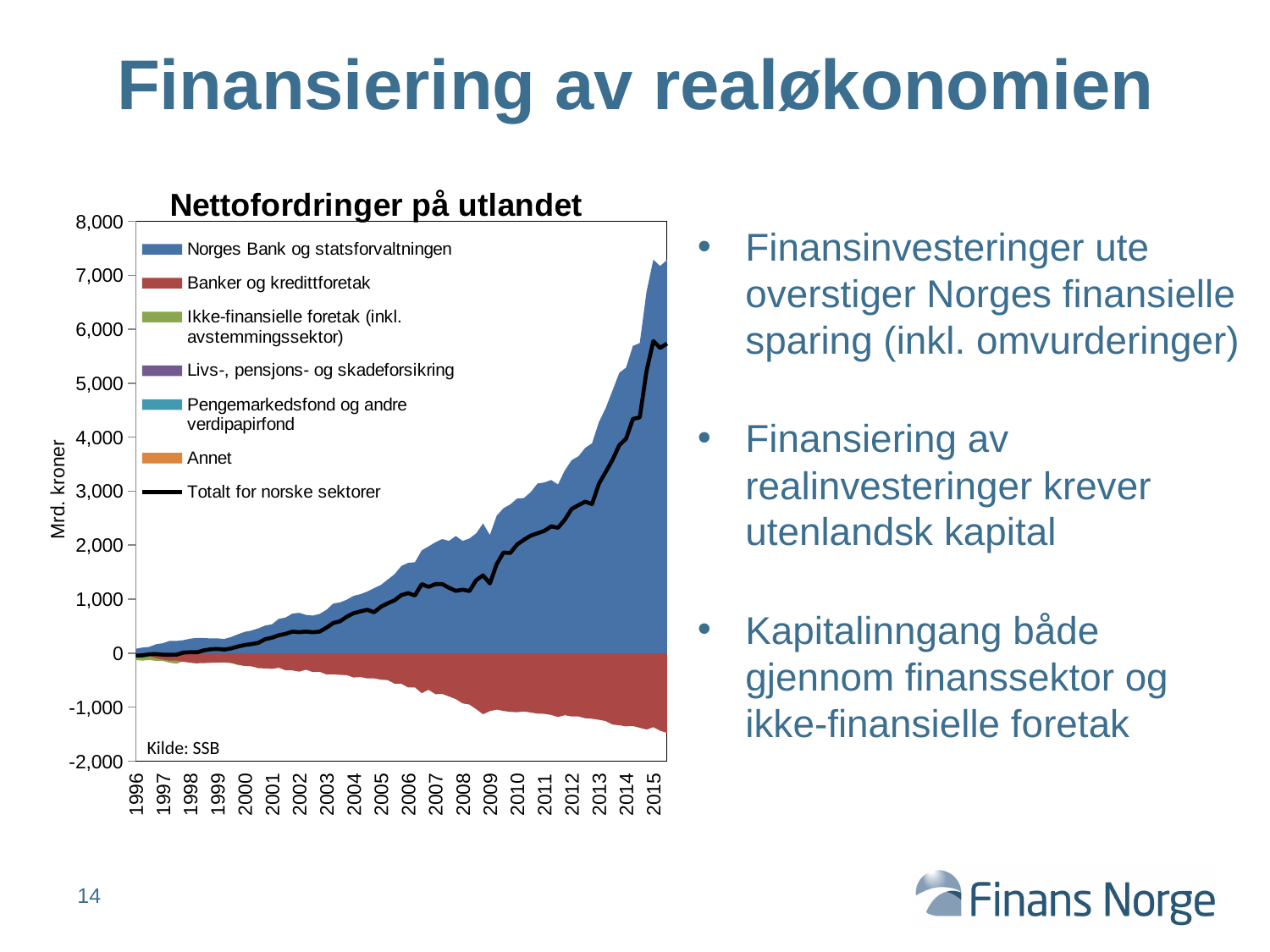
How many years are labelled on the x axis? 20 How many series does the chart legend list? 7 What kind of chart is shown on the slide? Area chart with a line Is the value for Norges Bank og statsforvaltningen in 2015 greater or less than 6,000? greater Does the line for Totalt for norske sektorer rise or fall from 1996 to 2015? Rise Is the value for Banker og kredittforetak in 2015 greater or less than -1,000? less Which series contributes the largest positive area in the chart? Norges Bank og statsforvaltningen Does the area for Banker og kredittforetak rise or fall (become more negative) from 1996 to 2015? Fall Is the value for Totalt for norske sektorer in 2015 greater or less than 5,000? greater What is the title of the chart? Nettofordringer på utlandet What is the label of the vertical axis? Mrd. kroner